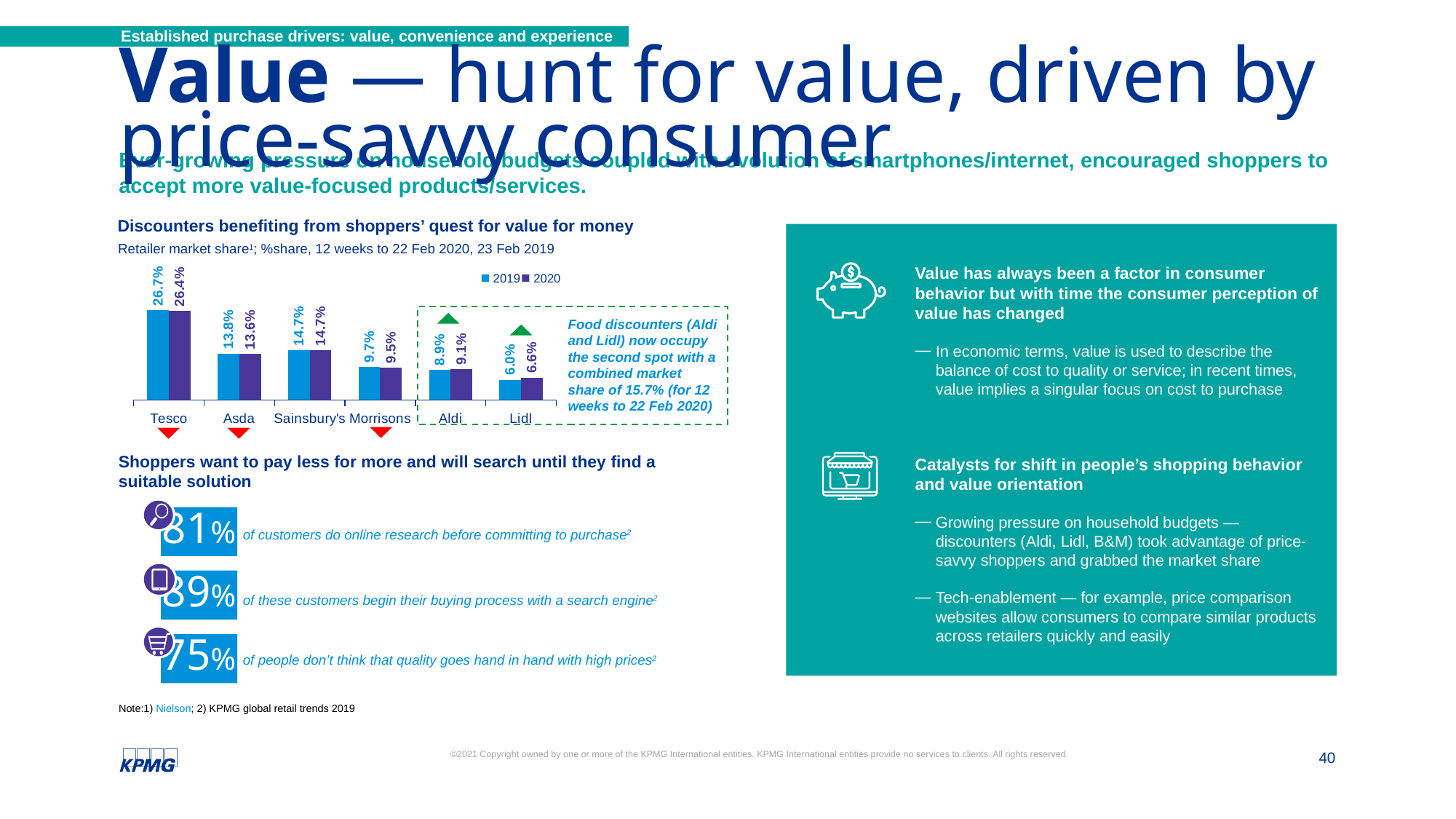
What is the difference between Lidl's market share in 2020 and 2019? 0.6% What was Aldi's retailer market share in 2020? 9.1% What was Lidl's retailer market share in 2020? 6.6% Which years are listed in the legend of the market share chart? 2019 and 2020 Which was larger in 2020: Asda's market share or Sainsbury's market share? Sainsbury's How many series does the legend of the market share chart list? 2 Which retailer had the lowest market share in 2019? Lidl What is the difference between Tesco's market share in 2019 and 2020? 0.3% What type of chart is used to show retailer market share? Bar chart How many retailers are shown in the market share chart? 6 What was Tesco's retailer market share in 2019? 26.7% Which retailer had the highest market share in 2020? Tesco